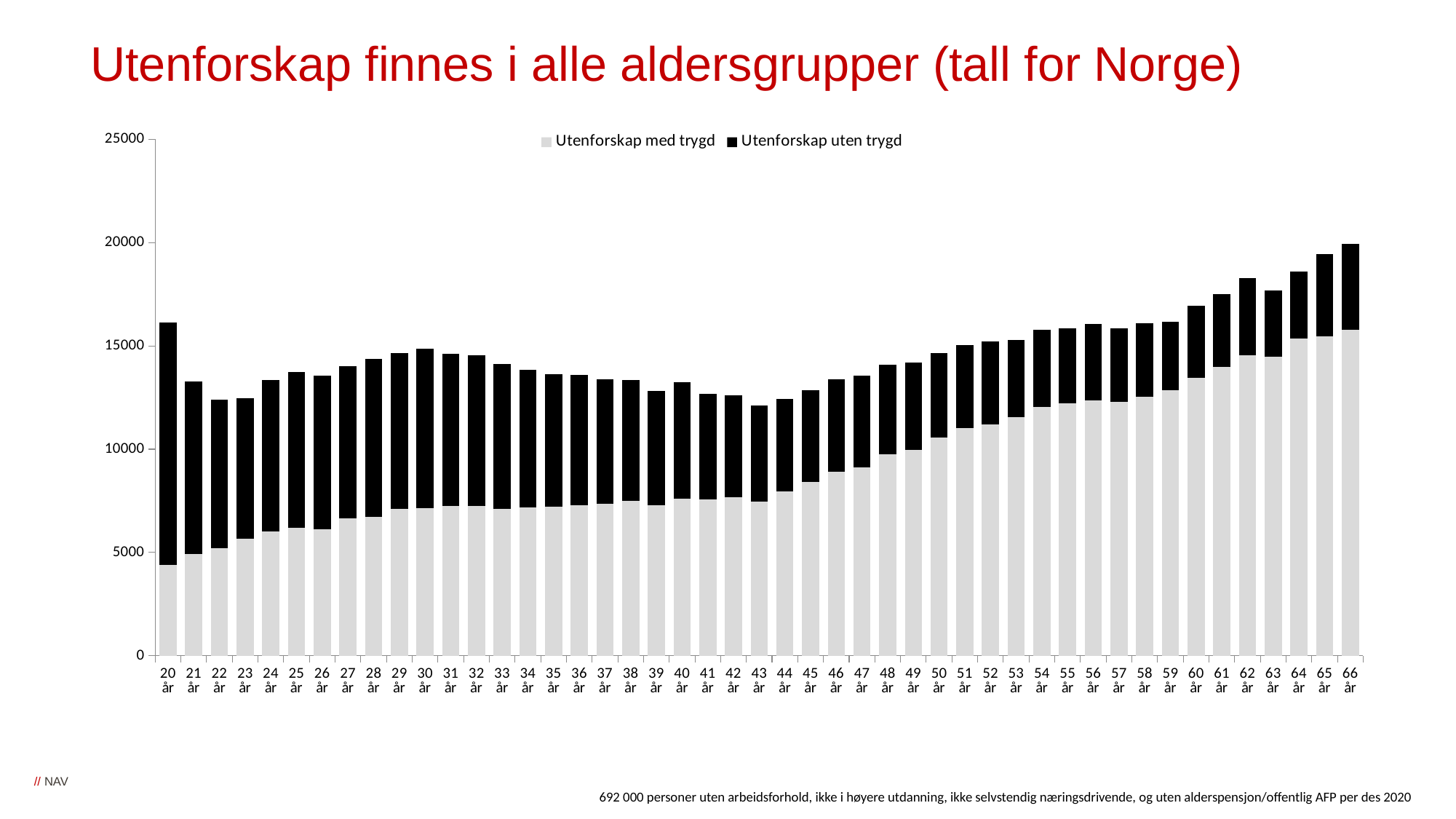
How many age groups are shown along the x axis? 47 Is the total bar for 43 år greater or less than 15000? less How many series does the legend list? 2 What kind of chart is shown on the slide? Stacked bar chart Which colour represents Utenforskap uten trygd in the legend? Black Which age group has the lowest value for Utenforskap med trygd? 20 år Which has the larger total bar, 20 år or 21 år? 20 år Which age group has the largest Utenforskap uten trygd segment? 20 år Is the Utenforskap med trygd value for 30 år greater or less than 10000? less Is the total bar for 20 år greater or less than 15000? greater Does the Utenforskap med trygd series generally rise or fall from 20 år to 66 år? rise Which age group has the highest total bar? 66 år